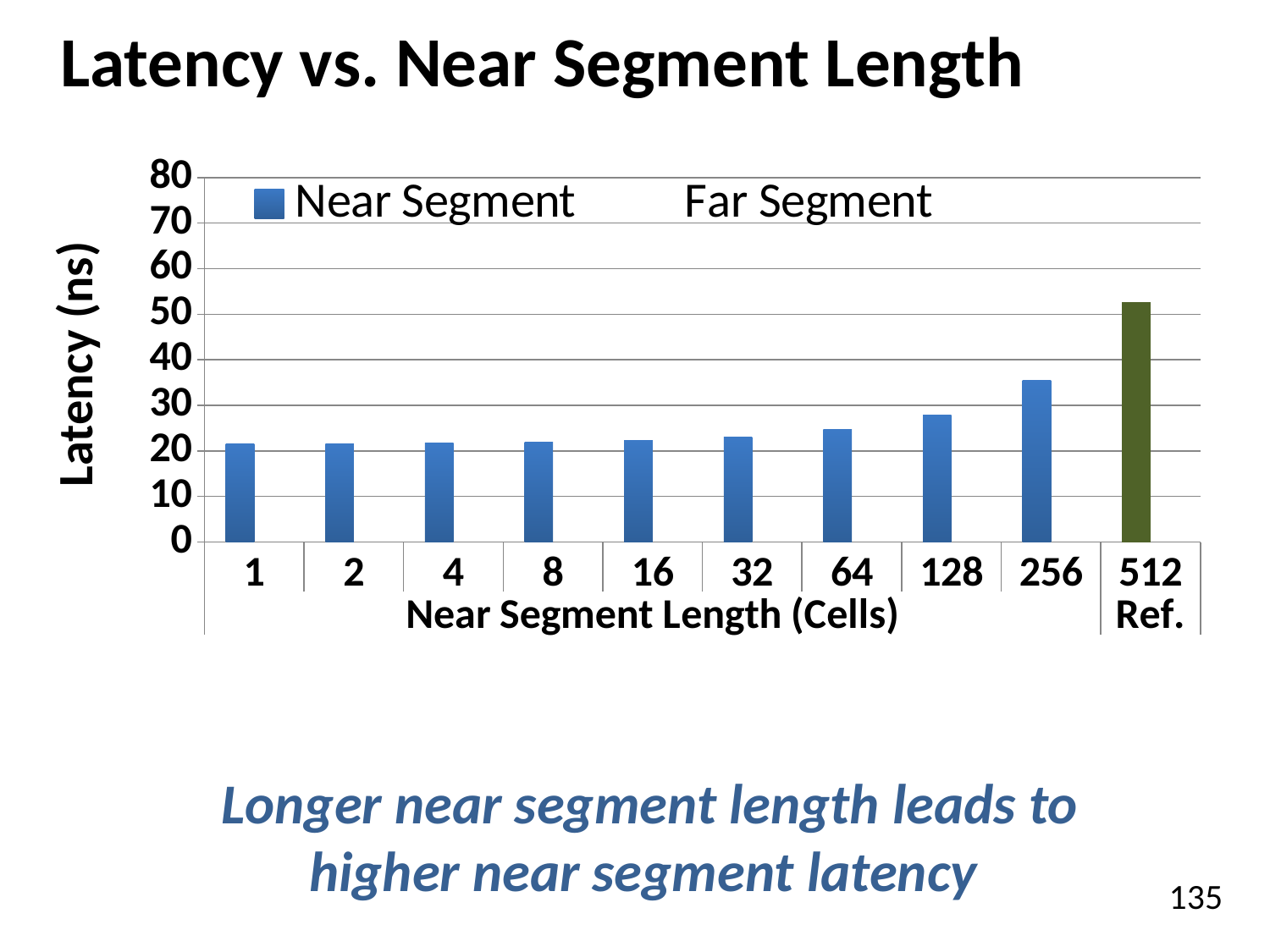
Is the latency for 256 greater or less than 30? greater Does the near segment latency rise or fall as near segment length increases from 1 to 256? rise Is the latency for 512 Ref. greater or less than 40? greater What kind of chart is shown on the slide? bar chart What is the title of the chart? Latency vs. Near Segment Length What is the label of the y axis? Latency (ns) How many series does the legend list? 2 Is the latency for 128 greater or less than 20? greater How many categories are shown on the x axis? 10 Which category has the highest latency? 512 Ref. Which has the higher latency, 256 or 64? 256